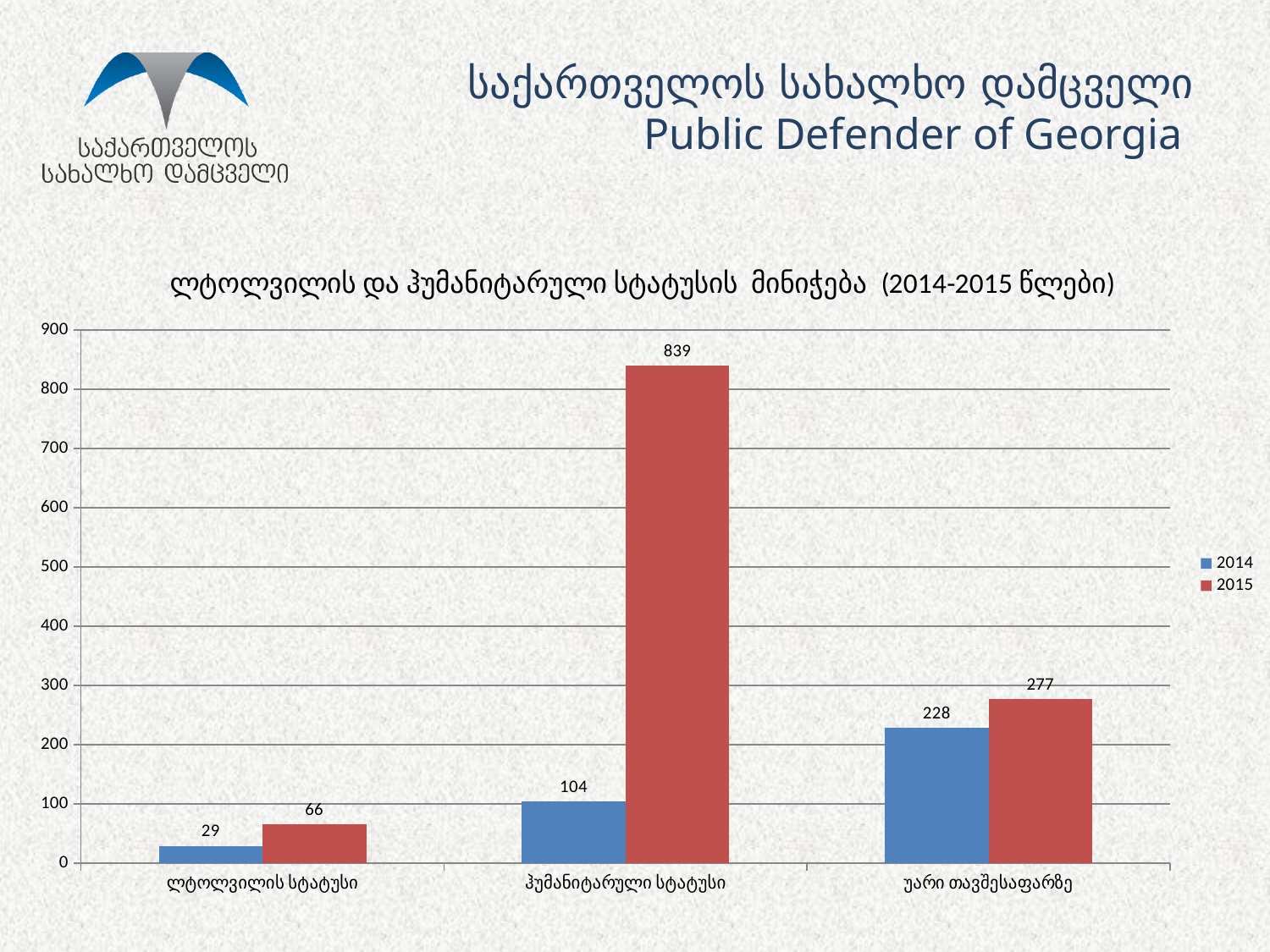
What is the 2015 value for ლტოლვილის სტატუსი? 66 Which category has the highest 2015 value? ჰუმანიტარული სტატუსი Which colour represents the 2015 series in the legend? red What type of chart is shown on the slide? bar chart Which category has the lowest 2014 value? ლტოლვილის სტატუსი What is the difference between the 2015 and 2014 values for ჰუმანიტარული სტატუსი? 735 How many categories are shown on the x axis? 3 Which is larger for უარი თავშესაფარზე, the 2014 value or the 2015 value? 2015 What is the 2015 value for ჰუმანიტარული სტატუსი? 839 How many series does the legend list? 2 What is the 2014 value for ლტოლვილის სტატუსი? 29 What is the 2014 value for უარი თავშესაფარზე? 228